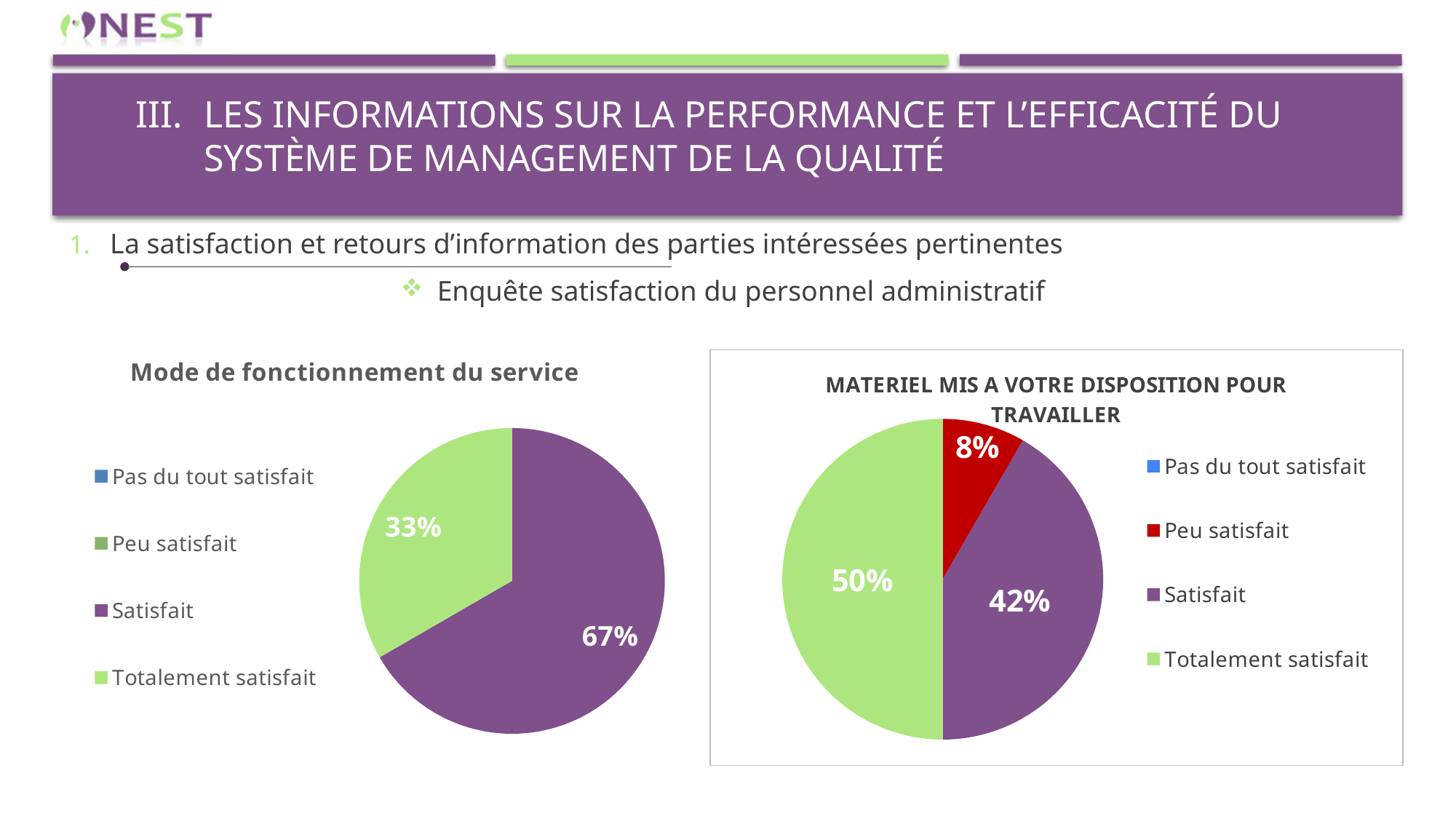
In the 'MATERIEL MIS A VOTRE DISPOSITION POUR TRAVAILLER' chart, what share of the pie is 'Peu satisfait'? 8% In the 'MATERIEL MIS A VOTRE DISPOSITION POUR TRAVAILLER' chart, what colour is the 'Peu satisfait' slice? Red In the 'MATERIEL MIS A VOTRE DISPOSITION POUR TRAVAILLER' chart, what share of the pie is 'Satisfait'? 42% In the 'Mode de fonctionnement du service' chart, what share of the pie is 'Totalement satisfait'? 33% What kind of chart is 'Mode de fonctionnement du service'? Pie chart In the 'Mode de fonctionnement du service' chart, which category has the largest slice? Satisfait In the 'Mode de fonctionnement du service' chart, how many entries does the legend list? 4 In the 'Mode de fonctionnement du service' chart, what is the difference between the 'Satisfait' and 'Totalement satisfait' shares? 34% In the 'MATERIEL MIS A VOTRE DISPOSITION POUR TRAVAILLER' chart, which labelled category has the smallest slice? Peu satisfait In the 'MATERIEL MIS A VOTRE DISPOSITION POUR TRAVAILLER' chart, which is larger, 'Satisfait' or 'Totalement satisfait'? Totalement satisfait